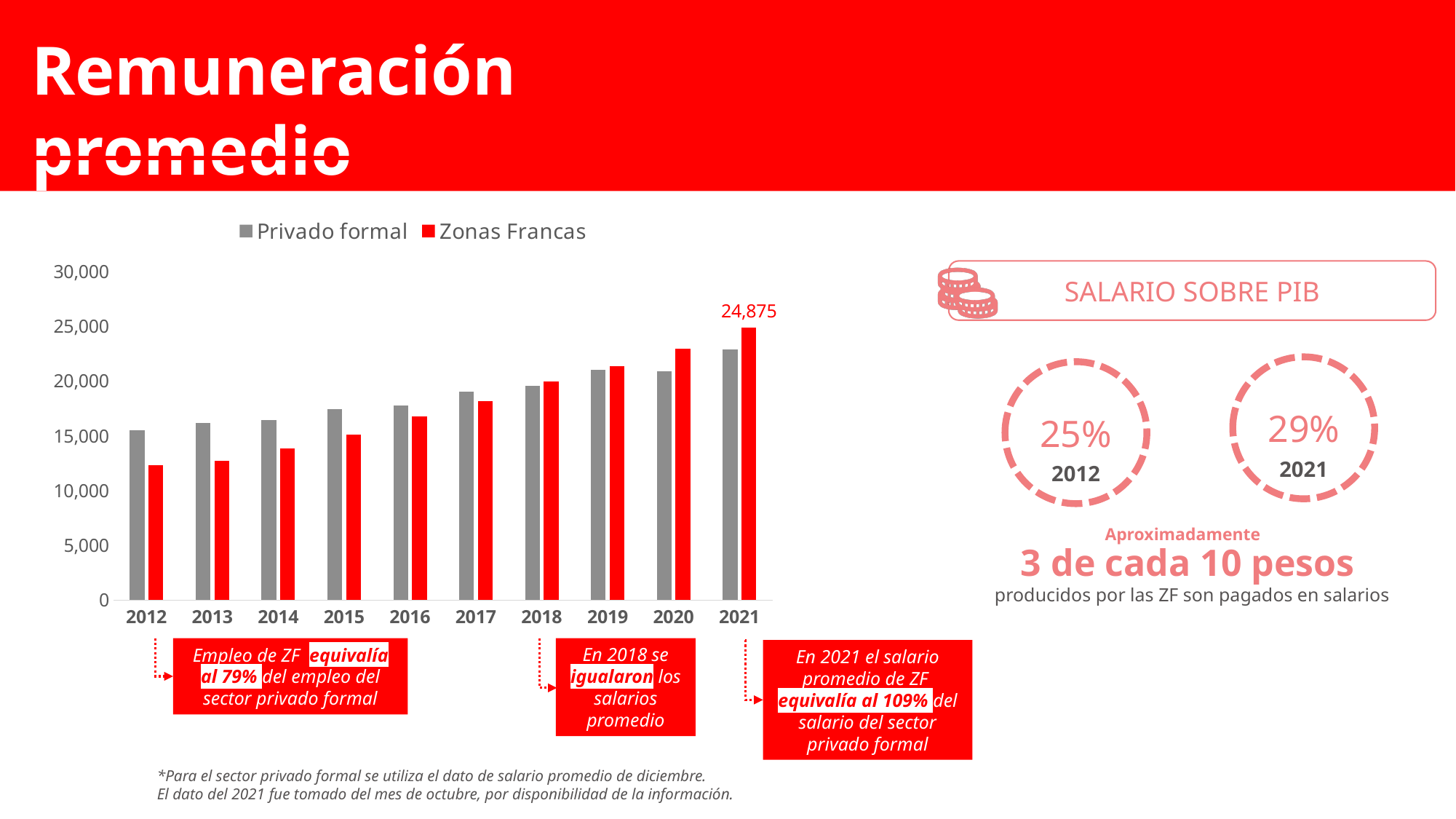
In 2012, which series has the larger value, Privado formal or Zonas Francas? Privado formal What colour are the Zonas Francas bars in the chart? red In which year is the Zonas Francas bar the highest? 2021 Is the value for Privado formal in 2021 greater or less than 20,000? greater Do the Zonas Francas values generally rise or fall from 2012 to 2021? rise What type of chart is shown on the slide? bar chart What is the labelled value of the Zonas Francas bar for 2021? 24,875 How many years are shown on the x axis of the chart? 10 In 2021, which series has the larger value, Privado formal or Zonas Francas? Zonas Francas Is the value for Zonas Francas in 2012 greater or less than 15,000? less In which year is the Zonas Francas bar the lowest? 2012 How many series does the chart legend list? 2